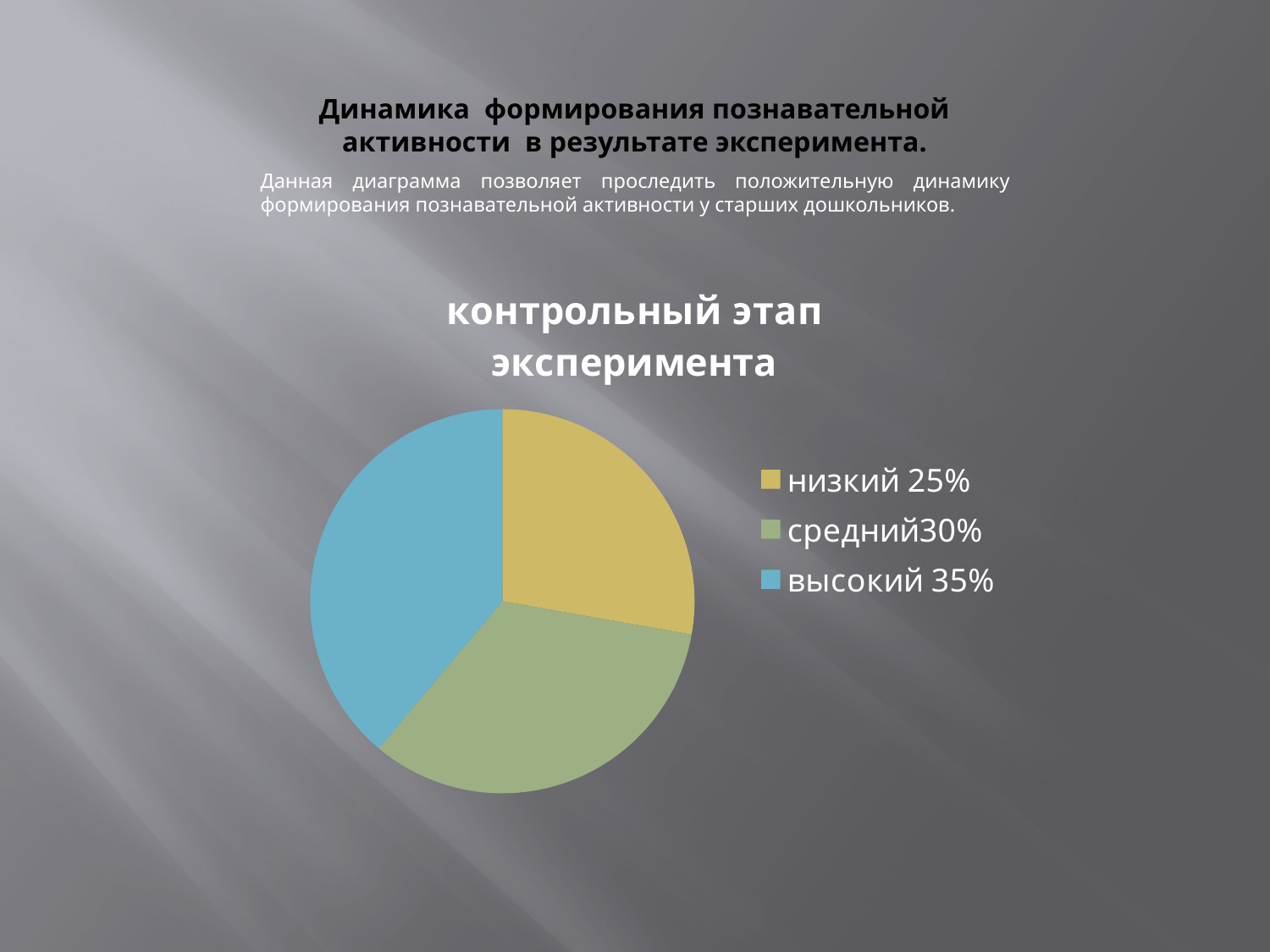
What kind of chart is shown on the slide? pie chart Which category has the largest share of the pie? высокий What is the combined share of "низкий" and "средний"? 55% What is the difference between the shares of "высокий" and "низкий"? 10% What percentage is shown for the category "средний"? 30% What percentage is shown for the category "высокий"? 35% What is the title of the chart? контрольный этап эксперимента What percentage is shown for the category "низкий"? 25% How many slices does the pie chart have? 3 Which category has the smallest share of the pie? низкий What colour represents the category "высокий" in the pie chart? blue Which is larger, the share of "средний" or the share of "низкий"? средний